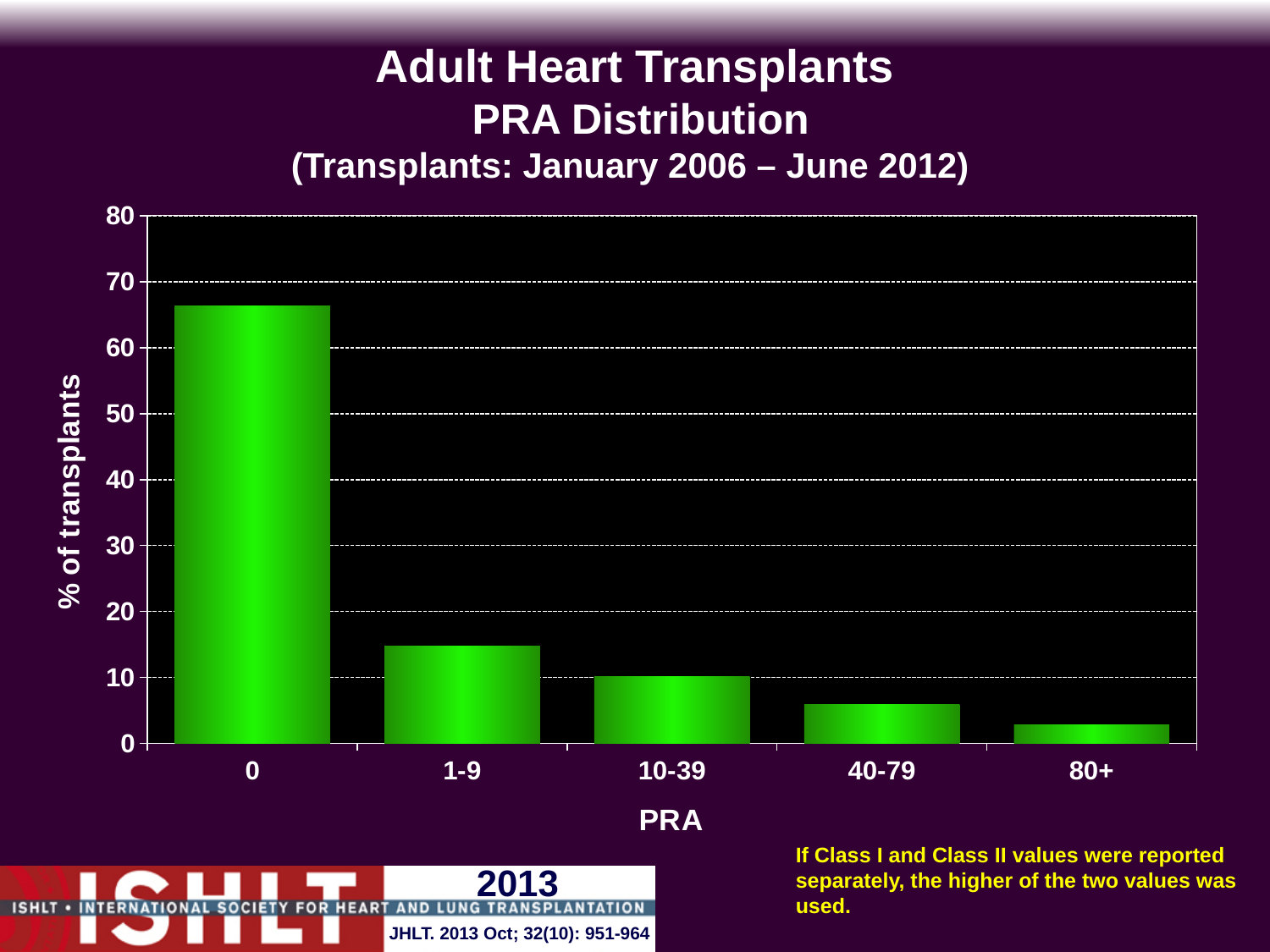
Is the value for the PRA 40-79 category greater or less than 10? less How many PRA categories are shown on the x axis? 5 What kind of chart is shown on the slide? bar chart Which PRA category has the lowest percentage of transplants? 80+ Is the value for the PRA 0 category greater or less than 60? greater Which PRA category has the highest percentage of transplants? 0 Which has a larger percentage of transplants, PRA 1-9 or PRA 40-79? 1-9 Do the values rise or fall as PRA increases along the x axis? fall Is the value for the PRA 10-39 category greater or less than 20? less What is the label of the y axis? % of transplants